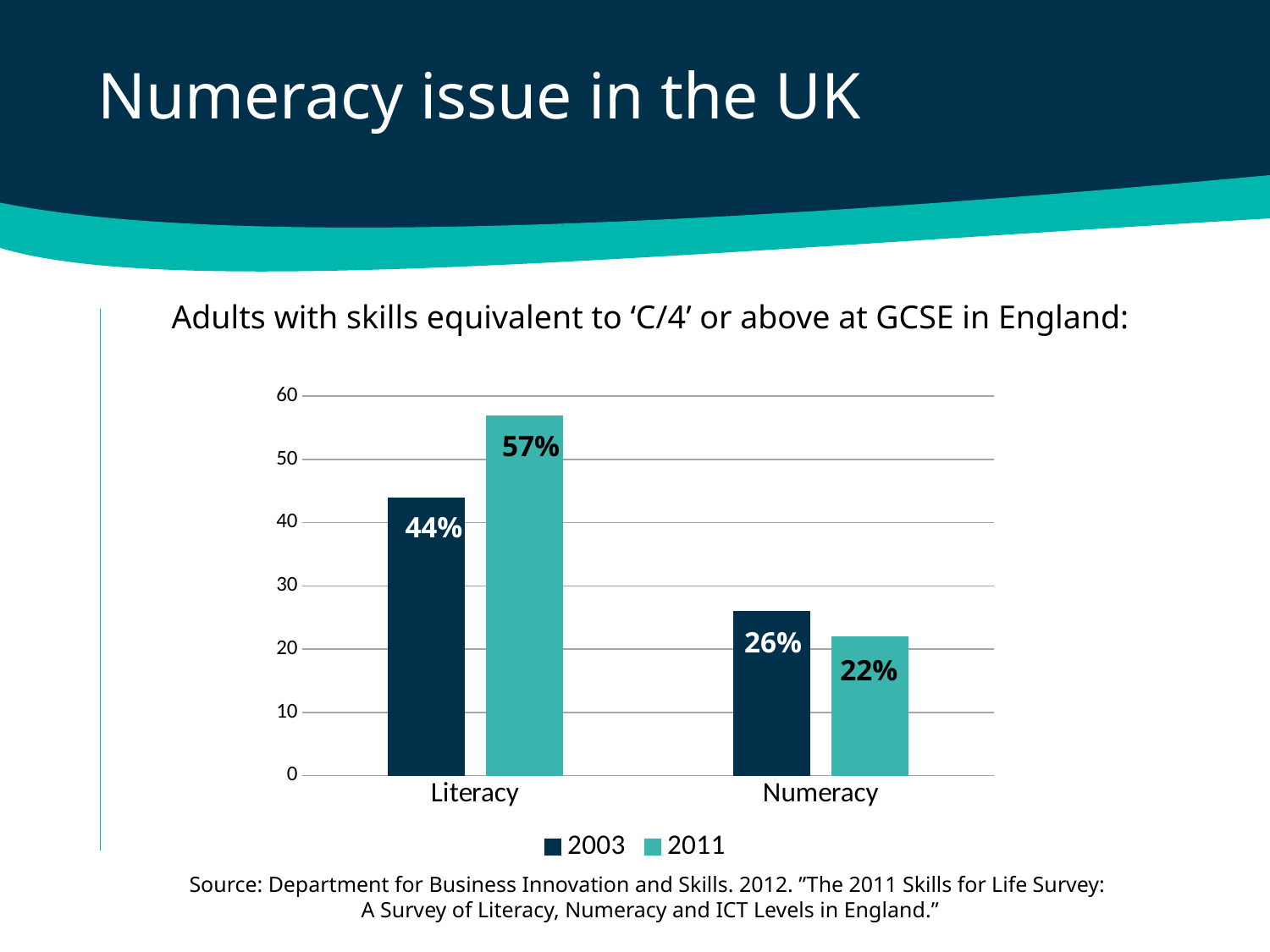
What is the value for Literacy in 2011? 57% What is the value for Numeracy in 2003? 26% How many categories are shown on the x axis? 2 Which category has the lowest value in 2011? Numeracy What is the difference between the Numeracy values for 2003 and 2011? 4% What is the value for Literacy in 2003? 44% How many series does the legend list? 2 What kind of chart is shown on the slide? Bar chart What is the value for Numeracy in 2011? 22% Which category has the highest value in 2011? Literacy Which is larger for Numeracy: the 2003 value or the 2011 value? 2003 What is the difference between the Literacy values for 2011 and 2003? 13%